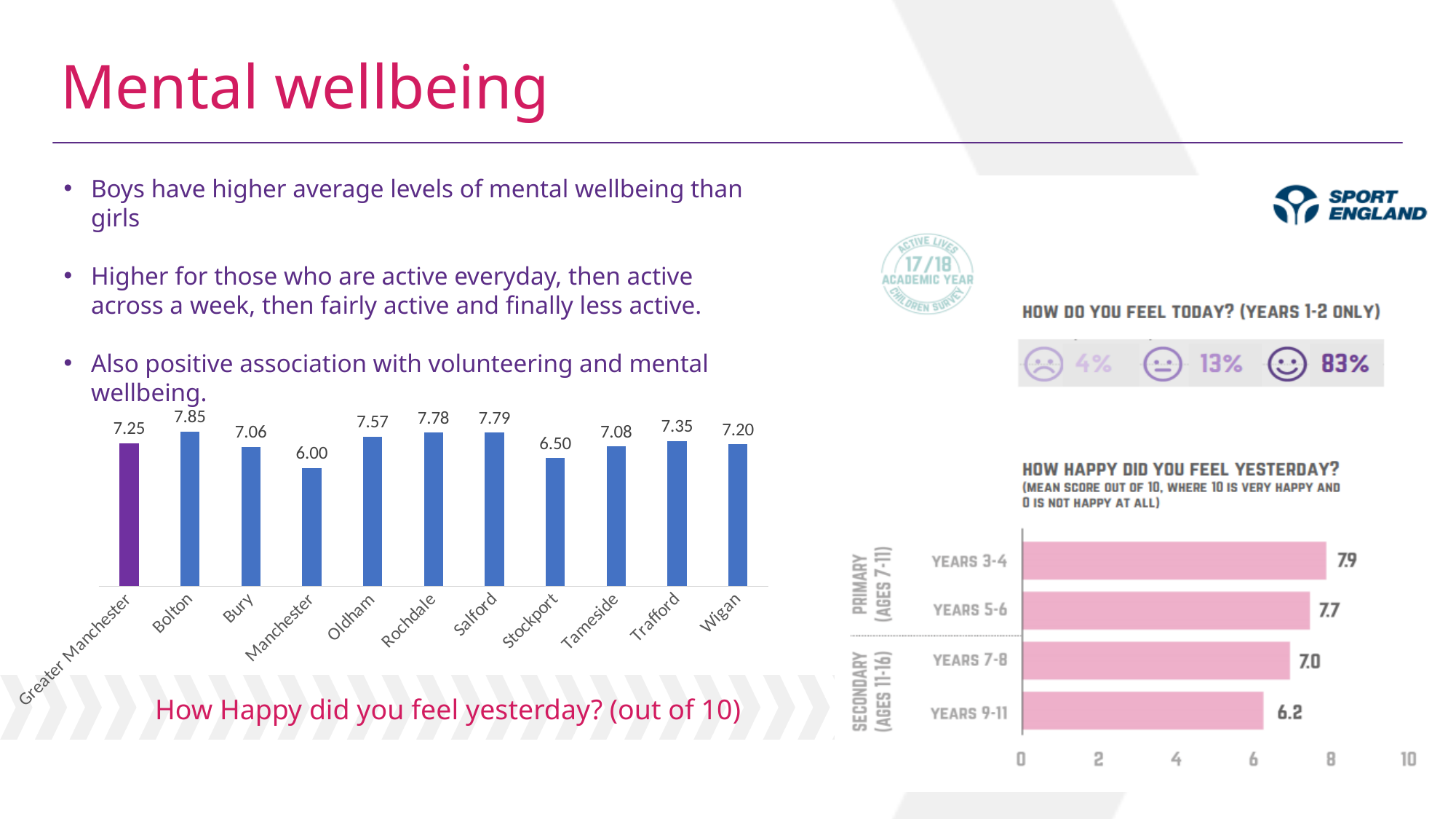
In the left chart 'How Happy did you feel yesterday? (out of 10)', which is larger, the value for Trafford or the value for Wigan? Trafford In the left chart 'How Happy did you feel yesterday? (out of 10)', what is the difference between the values for Salford and Stockport? 1.29 In the left chart 'How Happy did you feel yesterday? (out of 10)', which area has the lowest value? Manchester In the right chart 'How happy did you feel yesterday?', what is the mean score for Years 7-8? 7.0 In the left chart 'How Happy did you feel yesterday? (out of 10)', what is the value for Greater Manchester? 7.25 In the left chart 'How Happy did you feel yesterday? (out of 10)', which area has the highest value? Bolton How many areas are shown in the left chart 'How Happy did you feel yesterday? (out of 10)'? 11 What type of chart is the left chart 'How Happy did you feel yesterday? (out of 10)'? Bar chart In the left chart 'How Happy did you feel yesterday? (out of 10)', which bar is coloured differently from the others? Greater Manchester In the left chart 'How Happy did you feel yesterday? (out of 10)', what is the value for Bolton? 7.85 In the right chart 'How happy did you feel yesterday?', which year group has the lowest mean score? Years 9-11 In the right chart 'How happy did you feel yesterday?', do the mean scores rise or fall from Years 3-4 to Years 9-11? Fall